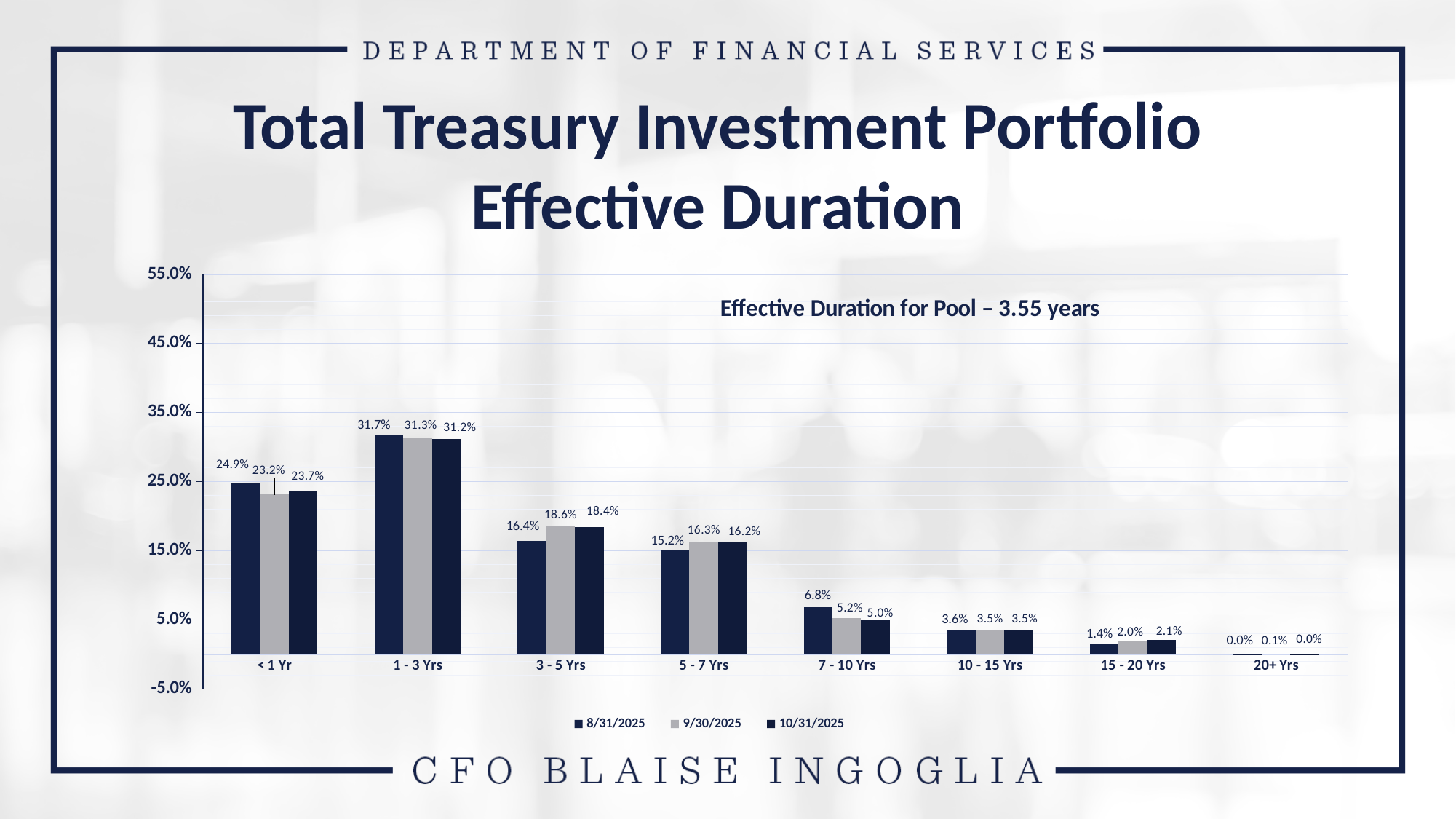
What is the value for the 7 - 10 Yrs category in the 10/31/2025 series? 5.0% Which category has the lowest value in the 8/31/2025 series? 20+ Yrs What is the value for the < 1 Yr category in the 9/30/2025 series? 23.2% What kind of chart is shown on the slide? Bar chart What effective duration for the pool is stated on the chart? 3.55 years What is the difference between the 8/31/2025 and 10/31/2025 values for the < 1 Yr category? 1.2% Which is larger for the 3 - 5 Yrs category: the 8/31/2025 value or the 9/30/2025 value? 9/30/2025 Which category has the highest value in the 10/31/2025 series? 1 - 3 Yrs What is the value for the 1 - 3 Yrs category in the 8/31/2025 series? 31.7% How many maturity categories are shown on the x axis? 8 Is the 10/31/2025 value for the 5 - 7 Yrs category greater or less than 15.0%? greater How many series does the legend list? 3